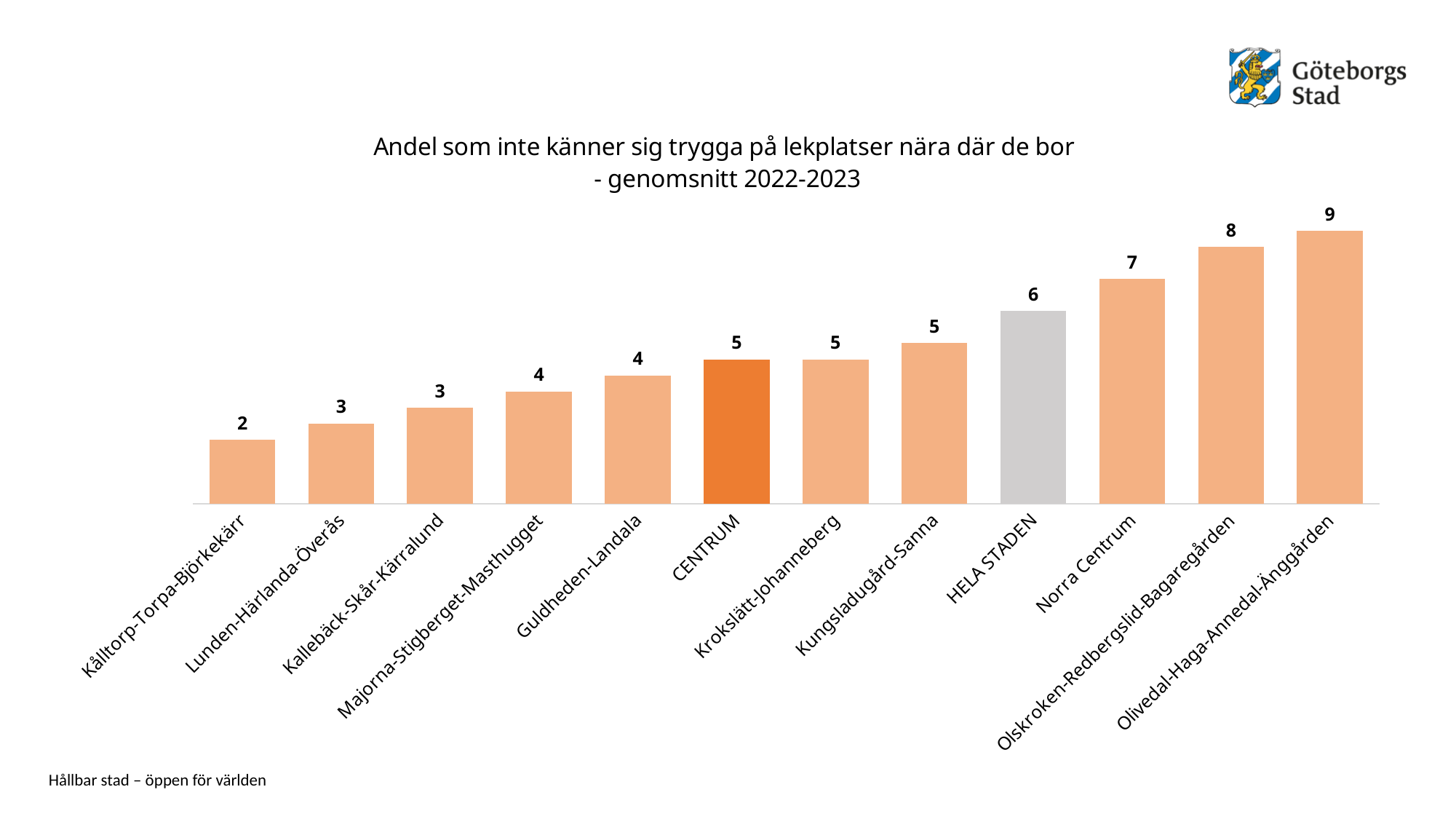
Which is larger, the value for Olskroken-Redbergslid-Bagaregården or the value for Guldheden-Landala? Olskroken-Redbergslid-Bagaregården How many categories are shown in the chart? 12 Which category has the lowest value? Kålltorp-Torpa-Björkekärr What kind of chart is shown on the slide? Bar chart What is the difference between the values for HELA STADEN and CENTRUM? 1 Do the values rise or fall from left to right along the x axis? Rise What is the value for CENTRUM? 5 What is the value for Kålltorp-Torpa-Björkekärr? 2 What is the difference between the values for Olivedal-Haga-Annedal-Änggården and Kålltorp-Torpa-Björkekärr? 7 Which category has the highest value? Olivedal-Haga-Annedal-Änggården What is the value for HELA STADEN? 6 What is the value for Norra Centrum? 7